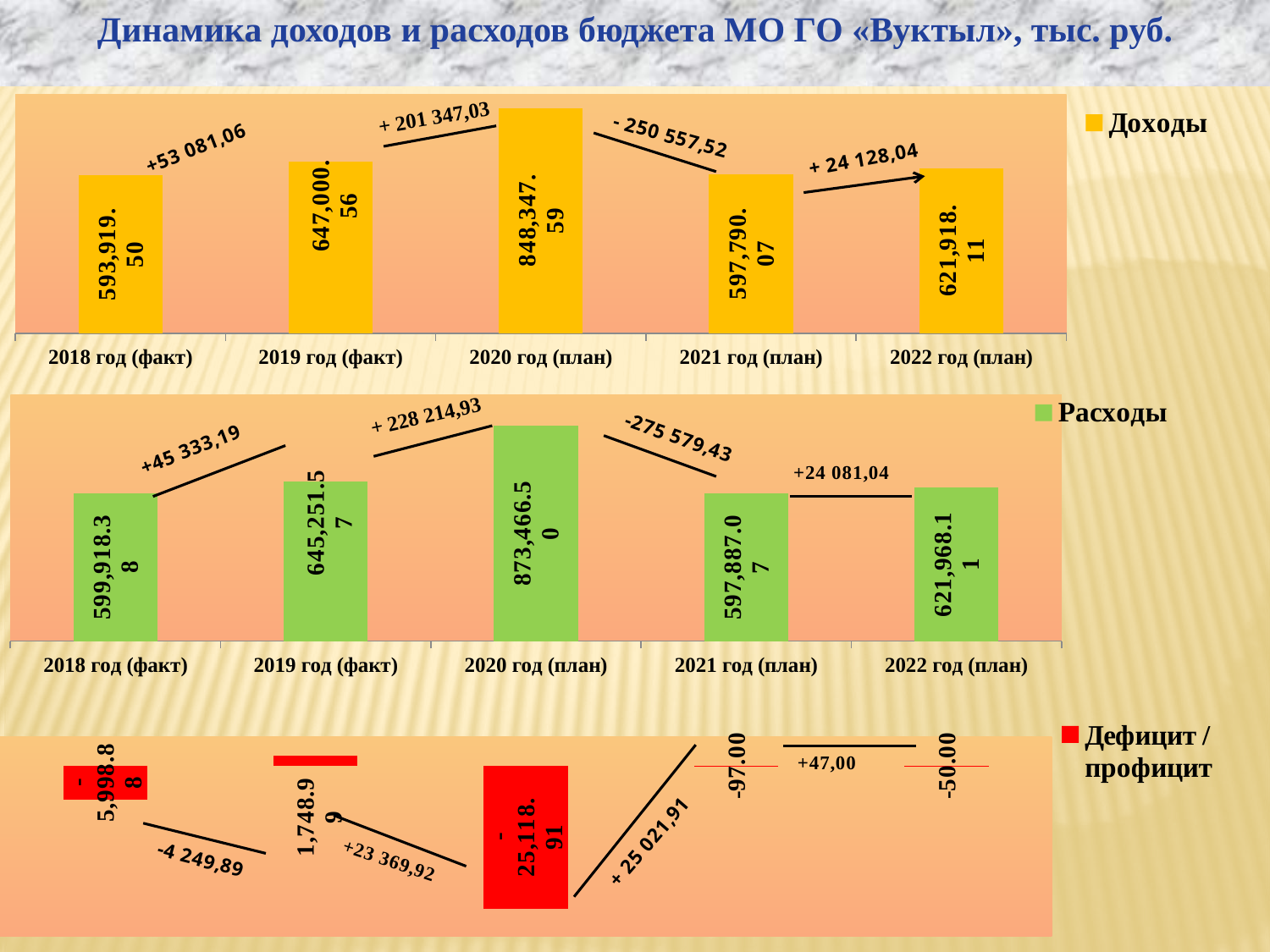
What colour are the bars in the Дефицит / профицит chart? red In the Доходы chart, what is the value for 2018 год (факт)? 593,919.50 In the Расходы chart, what is the value for 2022 год (план)? 621,968.11 In the Доходы chart, which category has the highest value? 2020 год (план) In the Дефицит / профицит chart, what is the value for the third bar (2020)? -25,118.91 In the Расходы chart, does the value rise or fall from 2019 год (факт) to 2020 год (план)? rise How many categories are shown in the Расходы chart? 5 In the Доходы chart, what is the value for 2020 год (план)? 848,347.59 For 2020 год (план), which is larger: the Доходы value or the Расходы value? Расходы In the Расходы chart, which category has the lowest value? 2021 год (план) In the Доходы chart, what is the difference between the values for 2022 год (план) and 2021 год (план)? 24,128.04 What kind of chart is the Доходы chart? bar chart